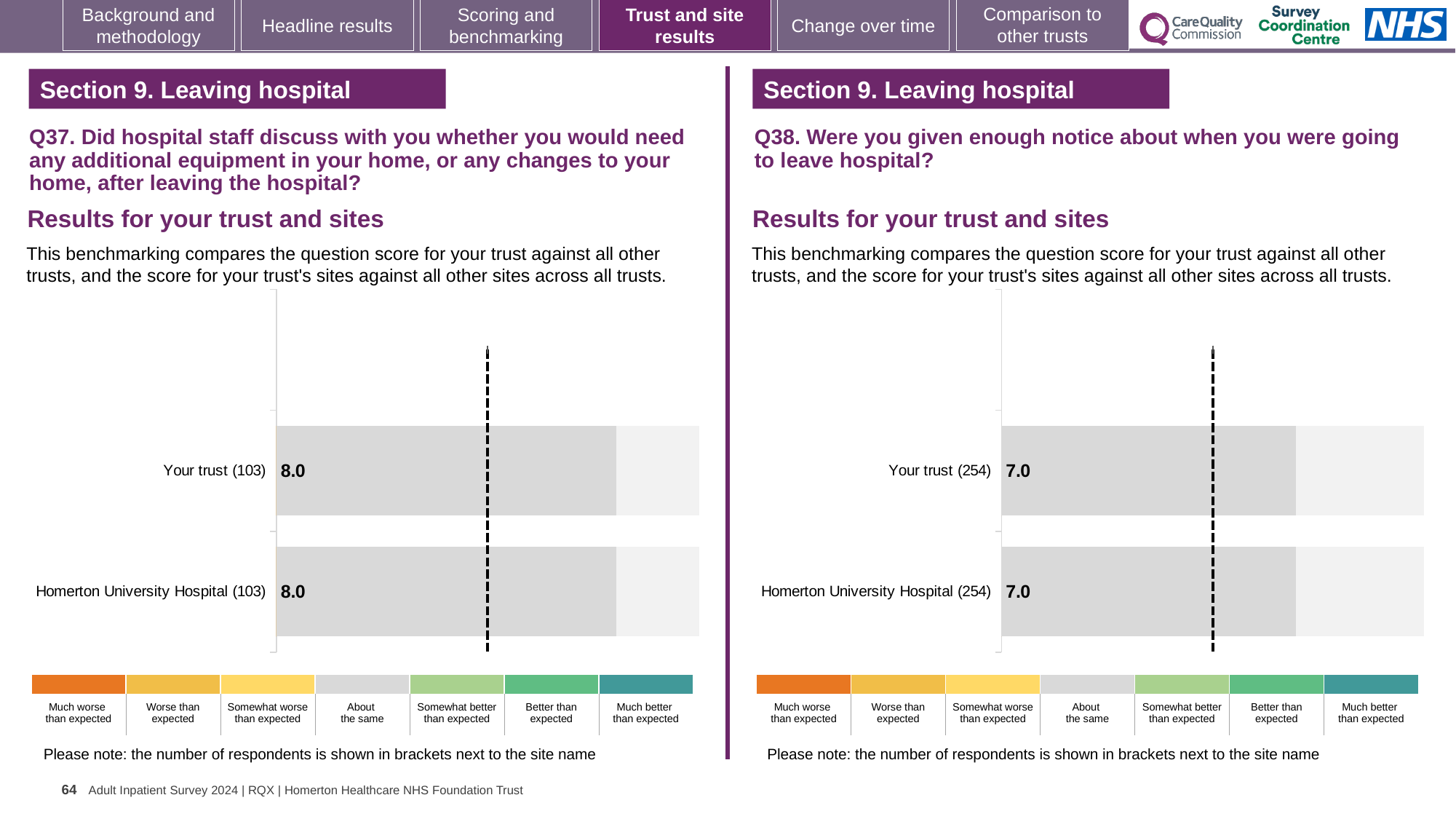
On the Q37 chart (left), what is the score for Homerton University Hospital (103)? 8.0 On the Q37 chart (left), what is the score for Your trust (103)? 8.0 On the Q38 chart (right), what is the score for Your trust (254)? 7.0 On the Q38 chart (right), what is the difference between the score for Your trust and the score for Homerton University Hospital? 0.0 What type of chart is used on the Q37 chart (left)? Bar chart Is the score for Your trust on the Q37 chart (left) larger than the score for Your trust on the Q38 chart (right)? Yes How many bars are plotted on the Q38 chart (right)? 2 On the Q38 chart (right), what is the score for Homerton University Hospital (254)? 7.0 On the Q37 chart (left), what is the difference between the score for Your trust and the score for Homerton University Hospital? 0.0 On the Q37 chart (left), which benchmarking category does the grey colour of the bars correspond to in the legend? About the same How many bars are plotted on the Q37 chart (left)? 2 On the Q38 chart (right), how many respondents are shown in brackets for Your trust? 254